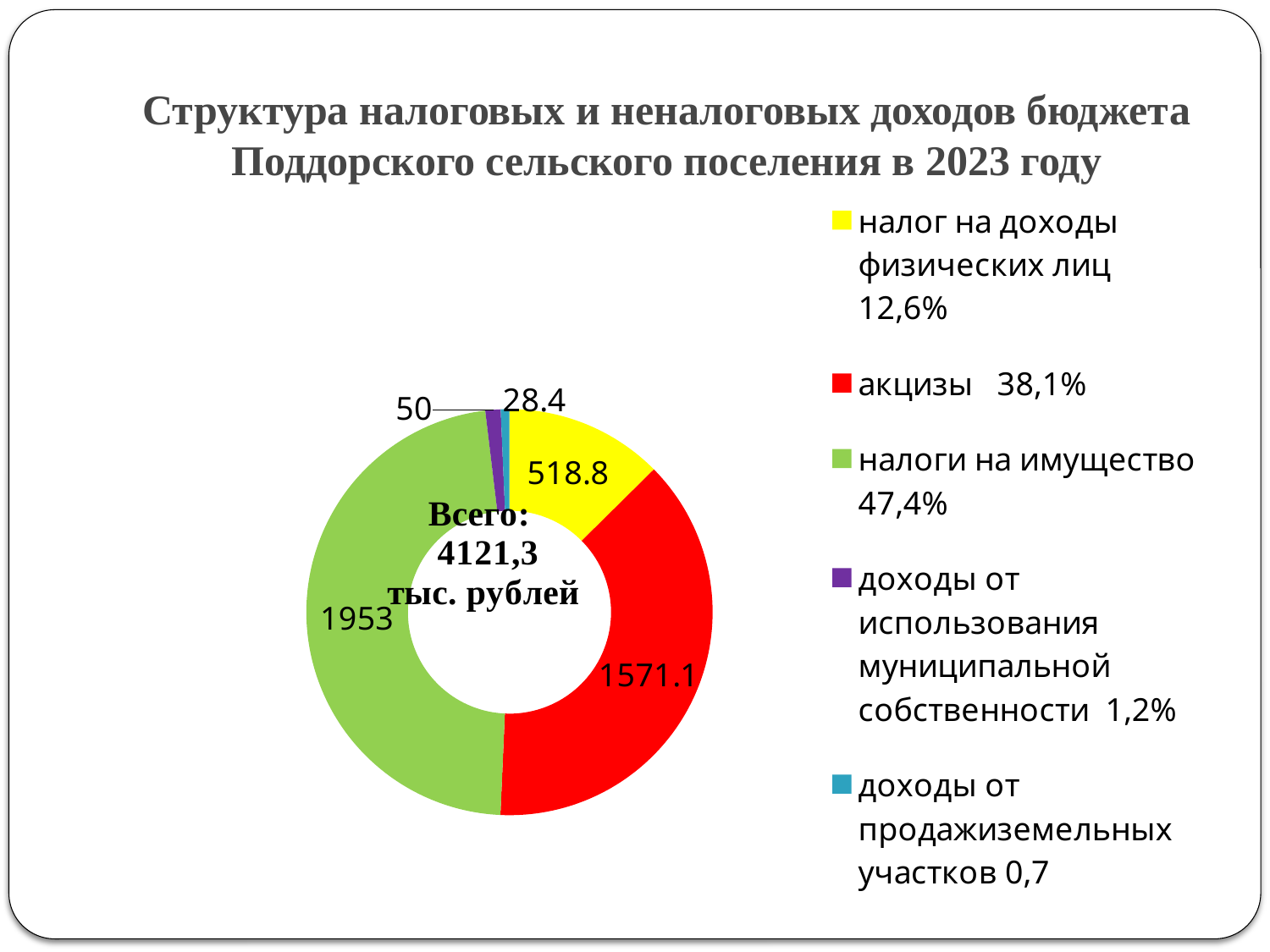
What type of chart is shown on the slide? Doughnut (pie) chart What colour represents акцизы in the chart? Red What is the value for акцизы? 1571.1 Which category has the largest value? налоги на имущество What total is printed in the centre of the chart? 4121,3 тыс. рублей How many categories does the chart show? 5 Which is larger: акцизы or налог на доходы физических лиц? акцизы What is the value for налог на доходы физических лиц? 518.8 Which category has the smallest value? доходы от продажи земельных участков What is the difference between налоги на имущество and акцизы? 381.9 What is the value for доходы от использования муниципальной собственности? 50 What share of the total do налоги на имущество make up, according to the legend? 47,4%